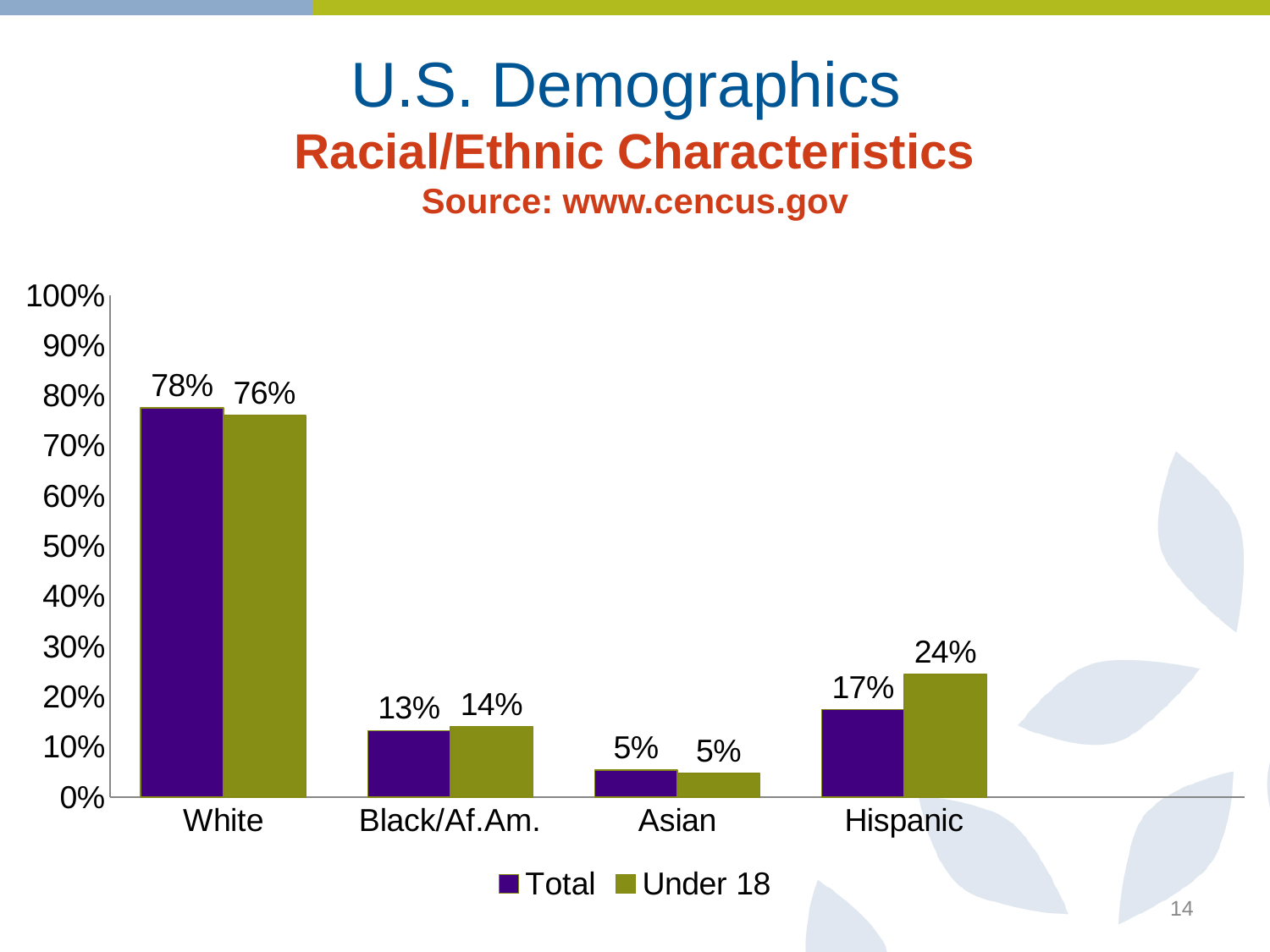
How many series does the legend list? 2 What is the Under 18 value for Black/Af.Am.? 14% What is the Total value for White? 78% What are the two series named in the legend? Total and Under 18 Which is larger for White: the Total value or the Under 18 value? Total Which category has the highest Total value? White How many categories are shown on the x axis? 4 Which category has the lowest Under 18 value? Asian What is the Under 18 value for Hispanic? 24% What is the difference between the Under 18 and Total values for Hispanic? 7% What kind of chart is shown on the slide? Bar chart What is the Total value for Asian? 5%